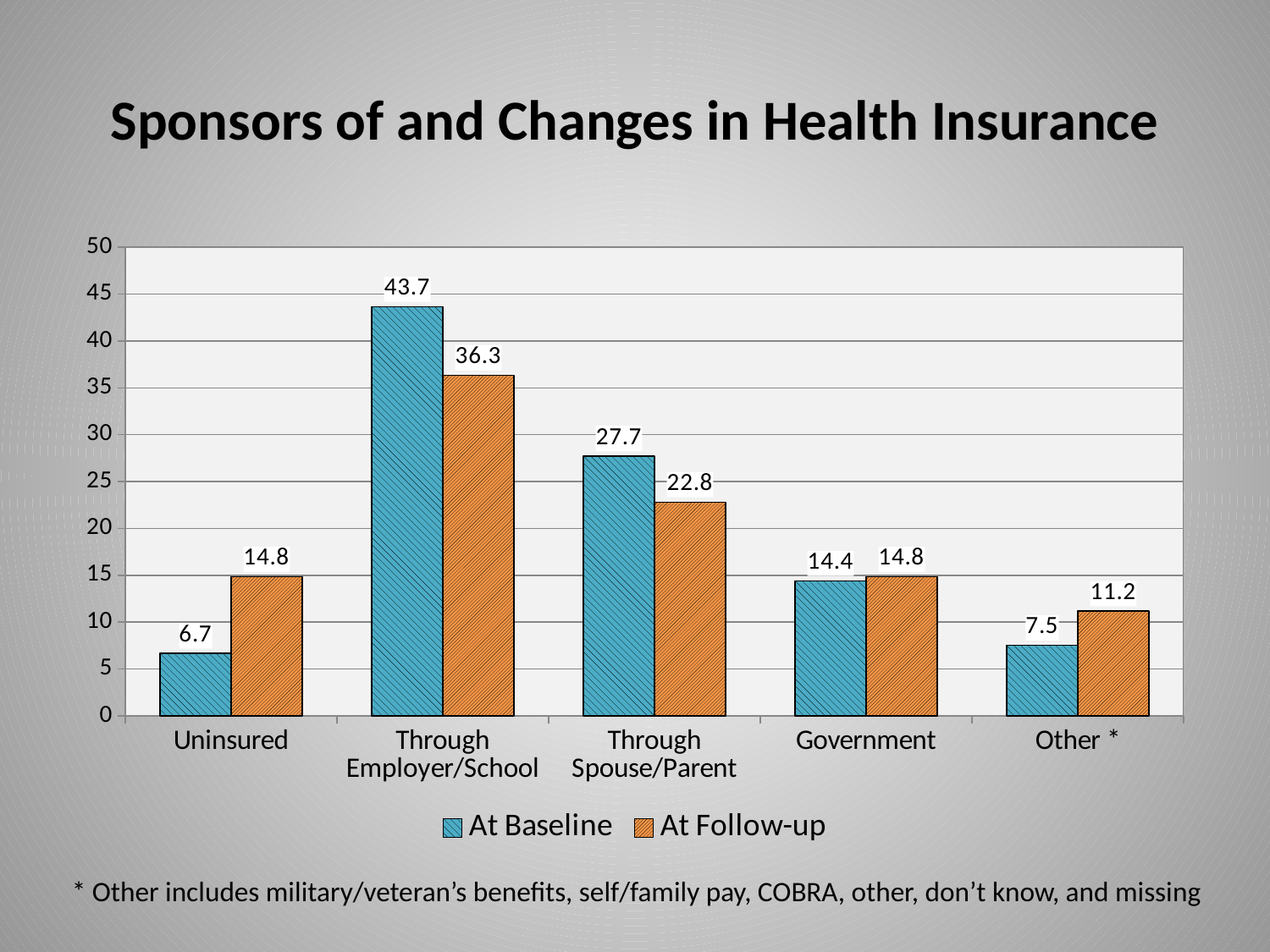
What kind of chart is shown on the slide? Bar chart Which category has the highest At Baseline value? Through Employer/School Is the At Follow-up value for Through Employer/School greater or less than 35? greater How many series does the legend list? 2 What is the title of the chart? Sponsors of and Changes in Health Insurance What is the At Baseline value for Uninsured? 6.7 How many categories are shown on the x axis? 5 Which category has the lowest At Follow-up value? Other * Which is larger for Uninsured: the At Baseline value or the At Follow-up value? At Follow-up What is the difference between the At Baseline and At Follow-up values for Through Spouse/Parent? 4.9 What is the At Follow-up value for Through Employer/School? 36.3 What is the At Baseline value for Government? 14.4